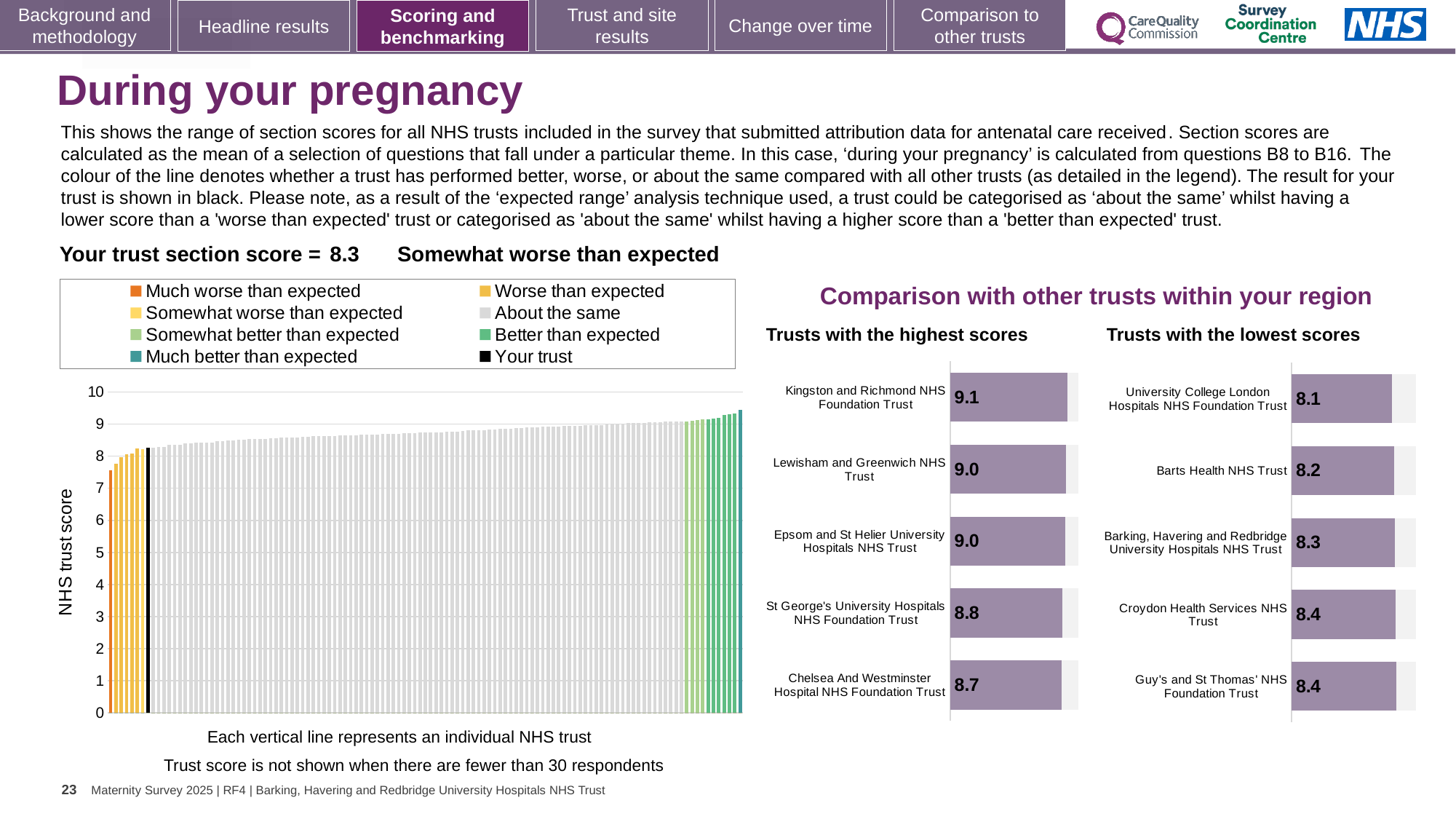
In the 'Trusts with the lowest scores' chart, what is the score for Barts Health NHS Trust? 8.2 In the 'Trusts with the highest scores' chart, what is the score for Kingston and Richmond NHS Foundation Trust? 9.1 What kind of chart is the NHS trust score chart on the left of the slide? Bar chart In the 'Trusts with the lowest scores' chart, which trust has the lowest score? University College London Hospitals NHS Foundation Trust In the 'Trusts with the lowest scores' chart, what is the difference between the scores of Guy's and St Thomas' NHS Foundation Trust and University College London Hospitals NHS Foundation Trust? 0.3 In the NHS trust score chart on the left, do the values rise or fall from left to right along the x axis? Rise In the 'Trusts with the highest scores' chart, which has the higher score: St George's University Hospitals NHS Foundation Trust or Chelsea And Westminster Hospital NHS Foundation Trust? St George's University Hospitals NHS Foundation Trust In the 'Trusts with the highest scores' chart, what is the difference between the scores of Kingston and Richmond NHS Foundation Trust and Chelsea And Westminster Hospital NHS Foundation Trust? 0.4 How many entries does the legend of the NHS trust score chart on the left list? 8 How many trusts are listed in the 'Trusts with the highest scores' chart? 5 In the 'Trusts with the lowest scores' chart, what is the score for Croydon Health Services NHS Trust? 8.4 In the 'Trusts with the highest scores' chart, which trust has the highest score? Kingston and Richmond NHS Foundation Trust